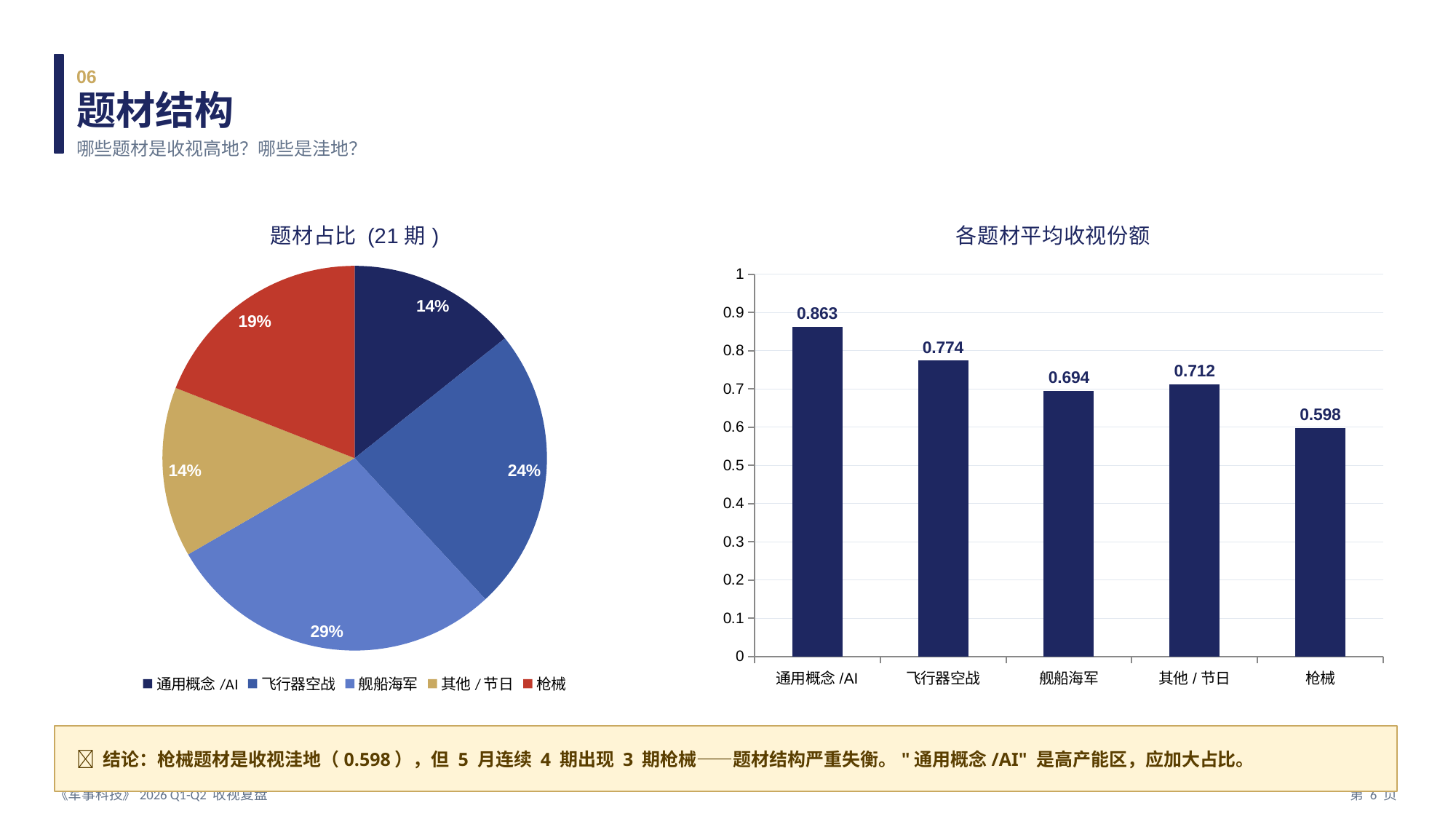
In the pie chart titled 题材占比（21 期）, which category has the largest slice? 舰船海军 In the pie chart titled 题材占比（21 期）, which category is shown in red? 枪械 In the pie chart titled 题材占比（21 期）, how many slices are there? 5 In the bar chart titled 各题材平均收视份额, what is the value for 通用概念 /AI? 0.863 In the bar chart titled 各题材平均收视份额, what is the difference between 通用概念 /AI and 枪械? 0.265 In the pie chart titled 题材占比（21 期）, what share does 舰船海军 have? 29% In the bar chart titled 各题材平均收视份额, which is larger, 舰船海军 or 其他 / 节日? 其他 / 节日 In the pie chart titled 题材占比（21 期）, what share does 枪械 have? 19% In the bar chart titled 各题材平均收视份额, what is the value for 其他 / 节日? 0.712 In the pie chart titled 题材占比（21 期）, what is the difference between the shares of 飞行器空战 and 枪械? 5% What kind of chart is the one titled 各题材平均收视份额? bar chart In the bar chart titled 各题材平均收视份额, which category has the lowest value? 枪械